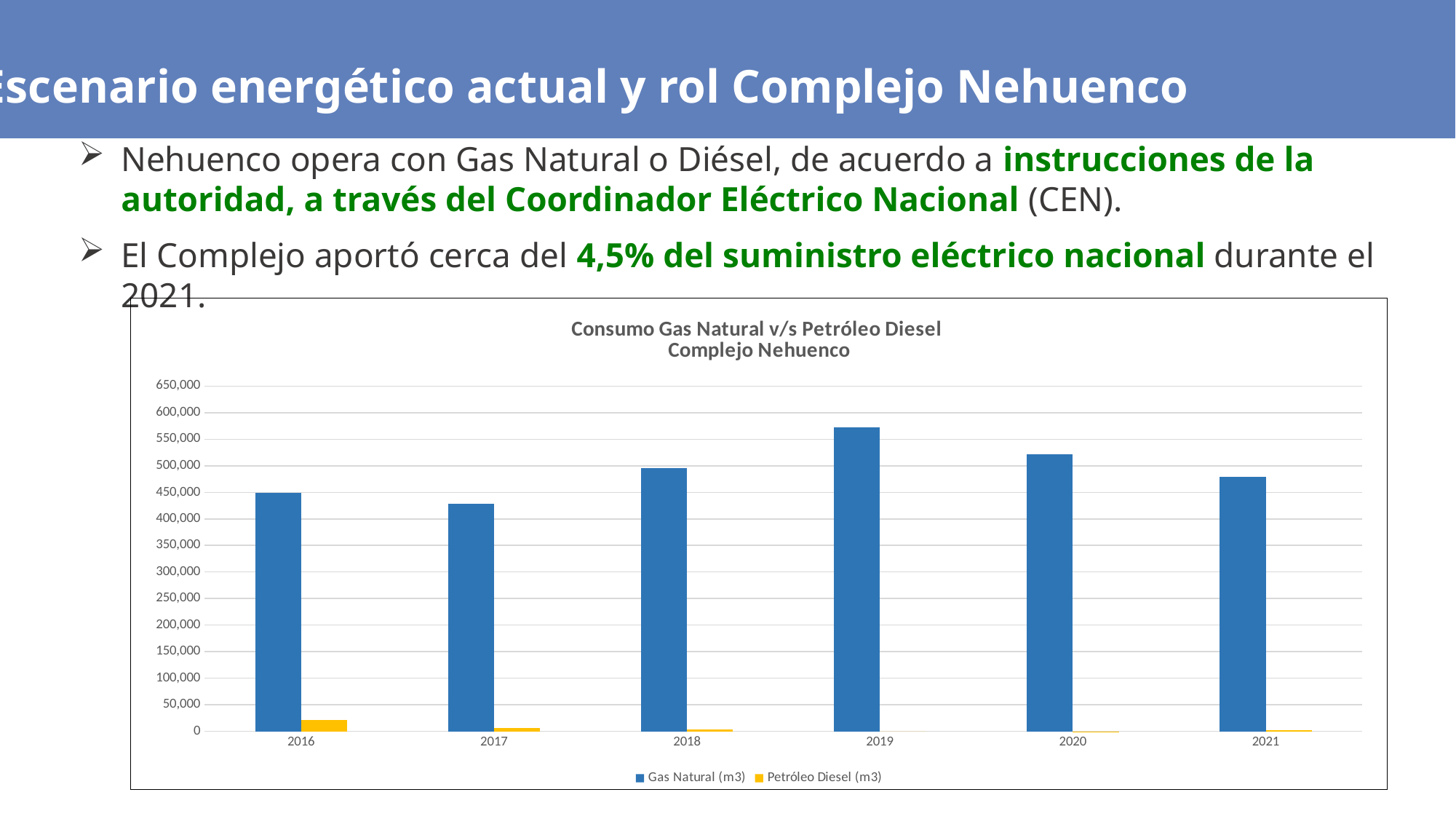
Is the Gas Natural (m3) value for 2017 greater or less than 450,000? less How many series does the legend list? 2 In which year is Gas Natural (m3) consumption highest? 2019 How many years are shown on the x axis? 6 What kind of chart is shown on the slide? bar chart What is the title of the chart? Consumo Gas Natural v/s Petróleo Diesel Complejo Nehuenco Is the Gas Natural (m3) value for 2020 greater or less than 500,000? greater In which year is Petróleo Diesel (m3) consumption highest? 2016 In which year is Gas Natural (m3) consumption lowest? 2017 Does Gas Natural (m3) consumption rise or fall from 2019 to 2021? fall Which year has the larger Gas Natural (m3) value, 2016 or 2020? 2020 Is the Gas Natural (m3) value for 2019 greater or less than 550,000? greater